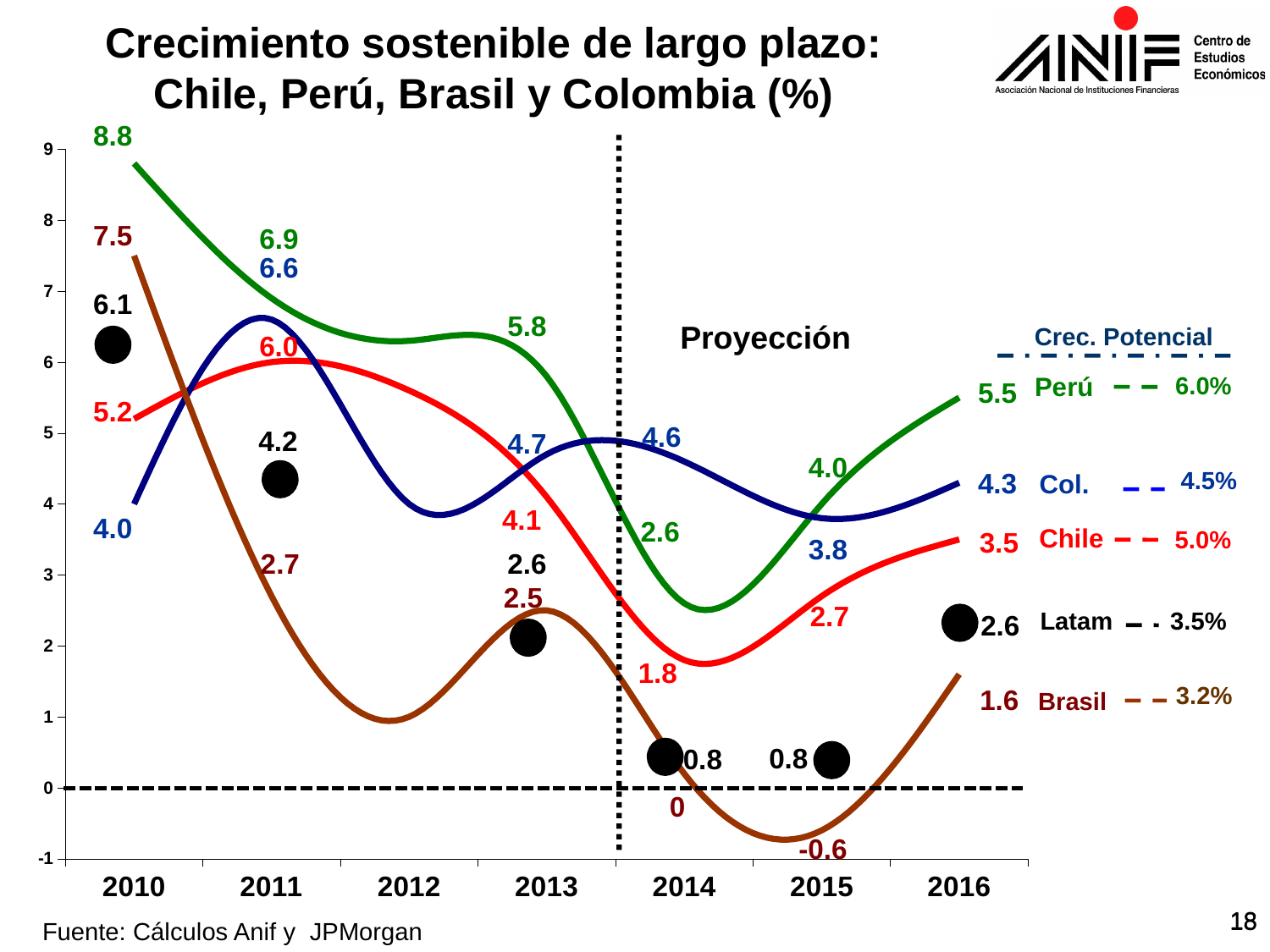
What is the value for Latam in 2016? 2.6 What is the value for Chile in 2014? 1.8 How many series does the legend list? 5 Which series has the lowest value in 2016? Brasil What is the difference between the Perú and Chile values in 2016? 2.0 What is the Crec. Potencial shown for Col.? 4.5% What kind of chart is shown on the slide? line chart Which series has the highest value in 2010? Perú What is the value for Brasil in 2015? -0.6 Which is larger in 2010, the value for Col. or the value for Chile? Chile Is the value for Brasil in 2012 greater or less than 2? less What is the value for Perú in 2010? 8.8